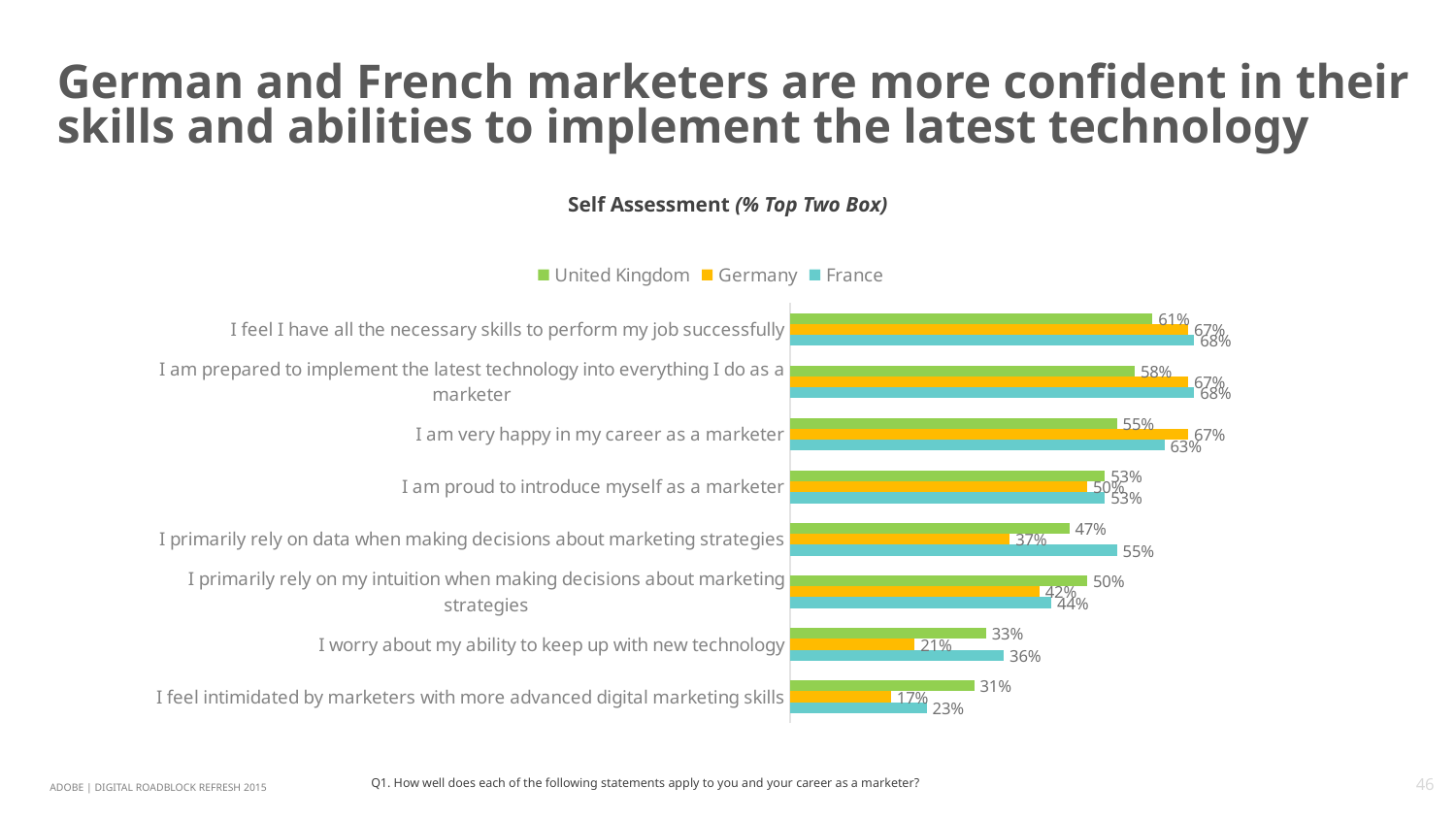
How many series does the legend list? 3 What is the difference between the United Kingdom and Germany values for "I feel intimidated by marketers with more advanced digital marketing skills"? 14% What is the value for France on "I worry about my ability to keep up with new technology"? 36% Which country has the highest value for "I primarily rely on data when making decisions about marketing strategies"? France Which country has the lowest value for "I worry about my ability to keep up with new technology"? Germany What is the value for Germany on "I primarily rely on data when making decisions about marketing strategies"? 37% Which is larger for "I primarily rely on my intuition when making decisions about marketing strategies": the United Kingdom value or the Germany value? United Kingdom What is the value for the United Kingdom on "I feel I have all the necessary skills to perform my job successfully"? 61% Which colour represents France in the chart? Blue How many statements are listed on the chart? 8 What type of chart is shown on the slide? Bar chart What is the value for Germany on "I feel intimidated by marketers with more advanced digital marketing skills"? 17%